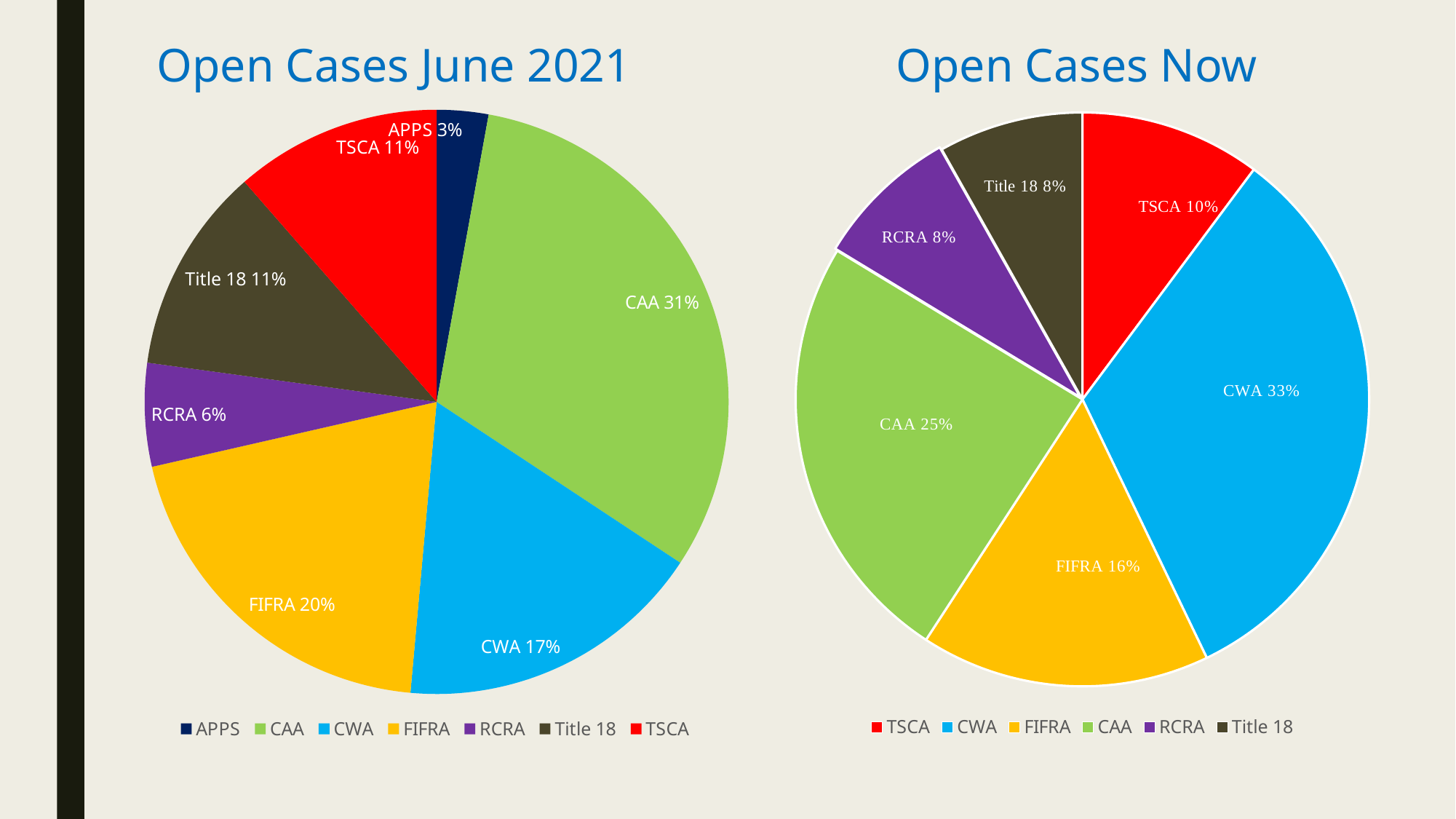
How many categories are shown in the 'Open Cases Now' chart? 6 In the 'Open Cases Now' chart, what colour is the TSCA slice? Red In the 'Open Cases June 2021' chart, which is larger, FIFRA or CWA? FIFRA In the 'Open Cases June 2021' chart, what share of open cases is RCRA? 6% In the 'Open Cases Now' chart, what share of open cases is CWA? 33% In the 'Open Cases Now' chart, which category has the largest slice? CWA In the 'Open Cases June 2021' chart, which category has the smallest slice? APPS How many categories are shown in the 'Open Cases June 2021' chart? 7 In the 'Open Cases June 2021' chart, which category has the largest slice? CAA In the 'Open Cases June 2021' chart, what share of open cases is CAA? 31% In the 'Open Cases Now' chart, what is the difference in percentage points between CWA and FIFRA? 17 What type of chart is 'Open Cases Now'? Pie chart